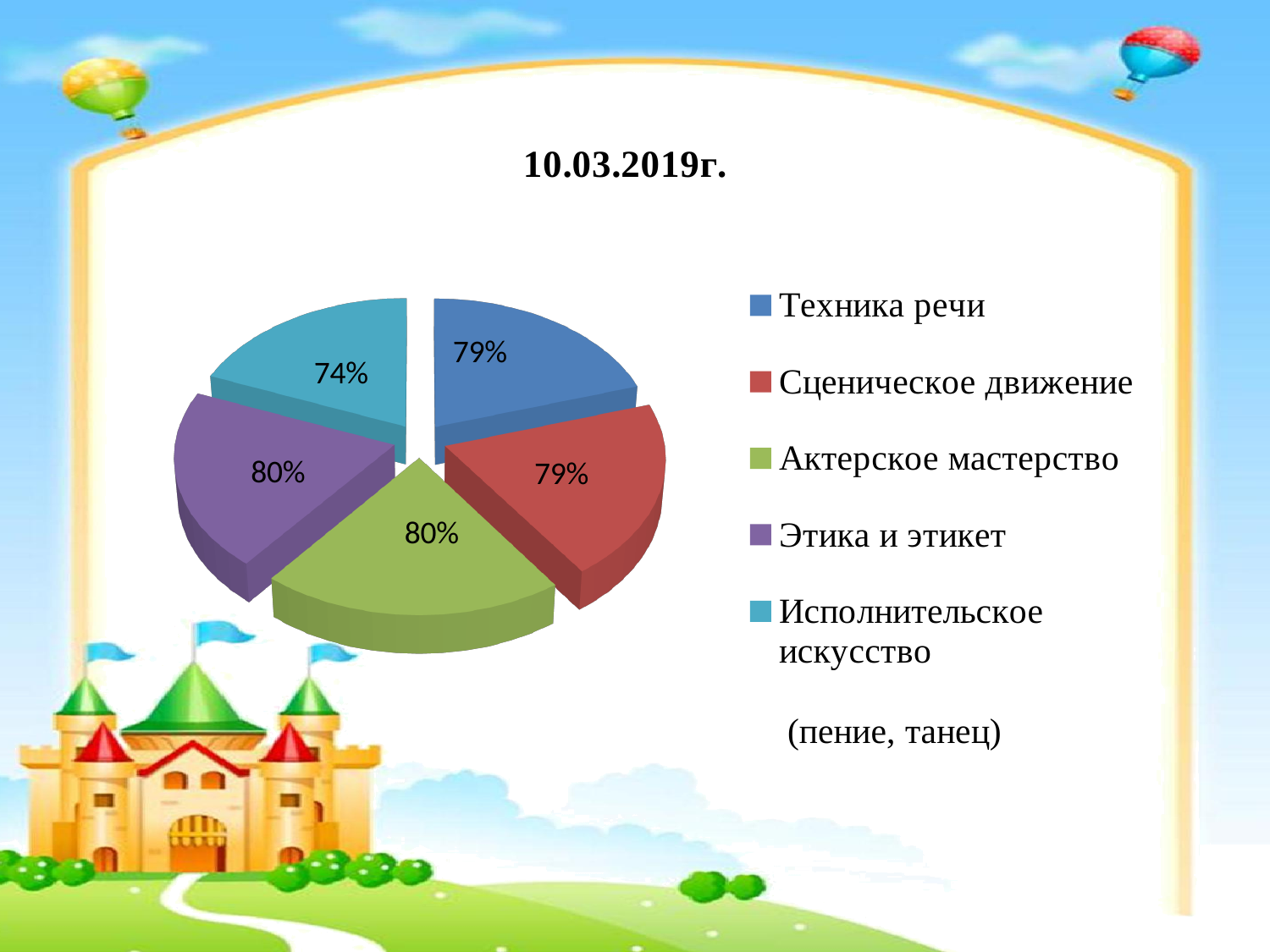
What value is shown for Сценическое движение? 79% What value is shown for Этика и этикет? 80% What type of chart is shown on the slide? pie chart What value is shown for Техника речи? 79% What is the title of the chart? 10.03.2019г. What is the difference between the value for Актерское мастерство and the value for Исполнительское искусство? 6% What value is shown for Актерское мастерство? 80% Which is larger, the value for Этика и этикет or the value for Исполнительское искусство? Этика и этикет What value is shown for Исполнительское искусство (пение, танец)? 74% How many slices does the pie chart have? 5 Which category has the lowest value? Исполнительское искусство (пение, танец) How many entries does the legend list? 5